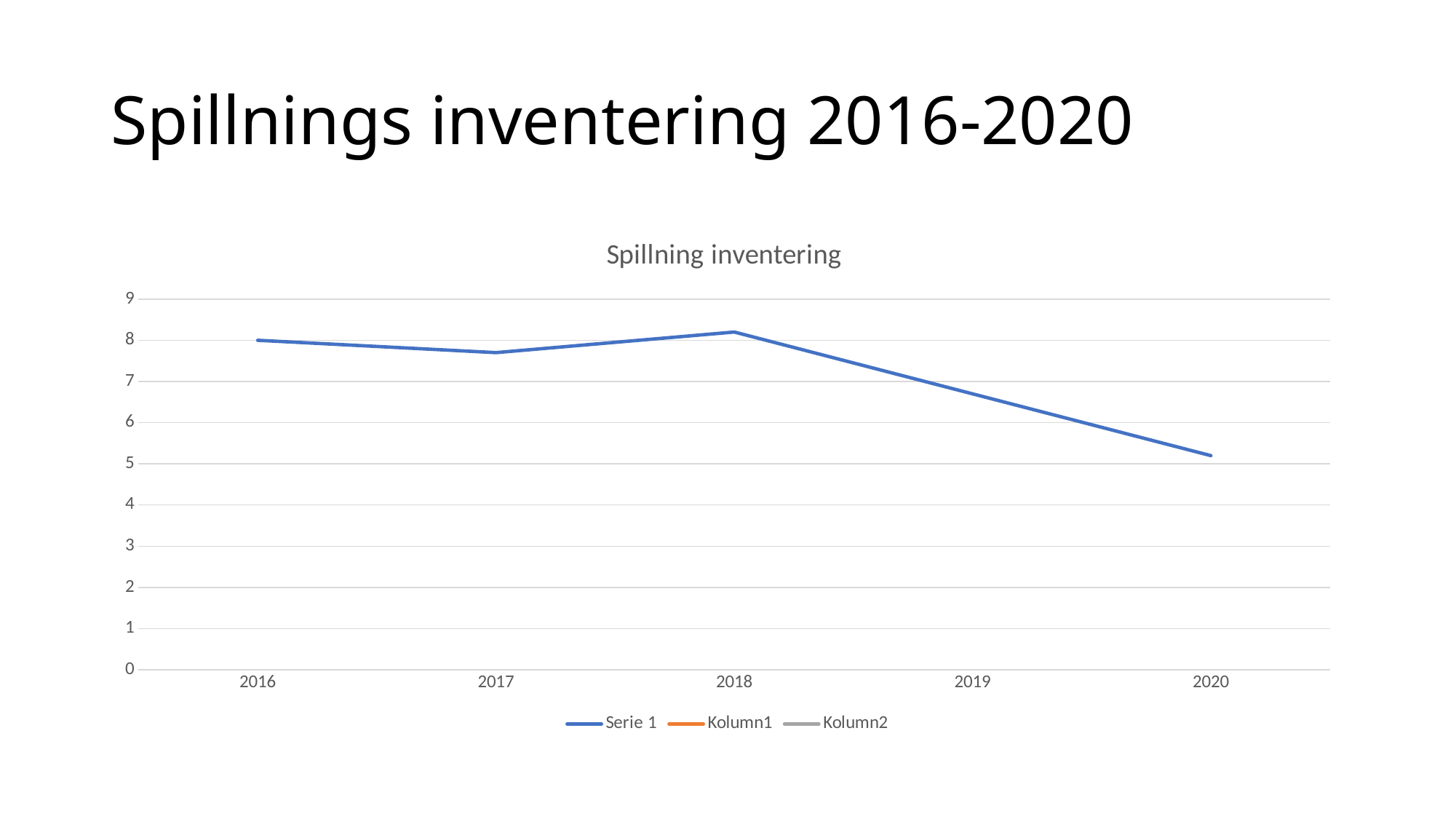
What is the title of the chart? Spillning inventering How many series does the legend list? 3 In which year does the Serie 1 line reach its lowest value? 2020 Which year has the larger value, 2016 or 2020? 2016 What kind of chart is shown on the slide? line chart Is the value for 2017 greater or less than 7? greater How many years are shown on the x axis of the chart? 5 Is the value for 2020 greater or less than 6? less In which year does the Serie 1 line reach its highest value? 2018 Is the value for 2019 greater or less than 8? less What are the names of the series listed in the legend? Serie 1, Kolumn1, Kolumn2 Does the Serie 1 line rise or fall from 2018 to 2020? fall